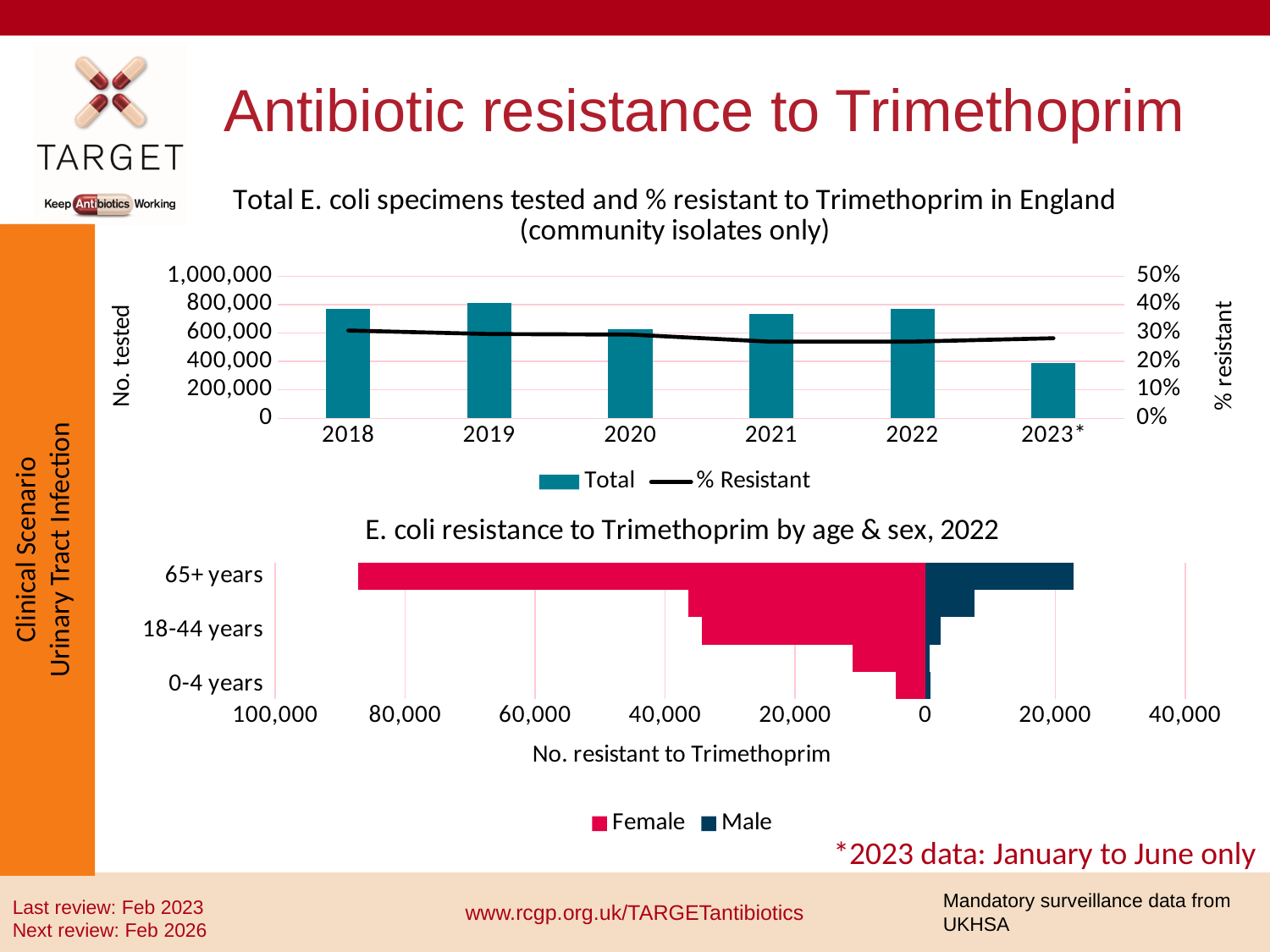
In the bottom chart 'E. coli resistance to Trimethoprim by age & sex, 2022', which sex has more resistant isolates in the 65+ years group? Female In the top chart, which year has the larger Total number tested, 2018 or 2020? 2018 In the bottom chart, what is the x-axis title? No. resistant to Trimethoprim In the top chart, is the Total number tested for 2021 greater or less than 600,000? greater In the top chart, does the % Resistant line rise or fall from 2018 to 2023*? It falls slightly In the top chart, which year has the highest Total number tested? 2019 In the top chart, which year has the lowest Total number tested? 2023* In the top chart, how many years are shown on the x axis? 6 What kind of chart is the top chart titled 'Total E. coli specimens tested and % resistant to Trimethoprim in England'? A bar chart combined with a line chart In the top chart, is the Total number tested for 2023* greater or less than 600,000? less In the top chart, how many series does the legend list? 2 In the bottom chart, is the number of resistant Female isolates in the 65+ years group greater or less than 80,000? greater